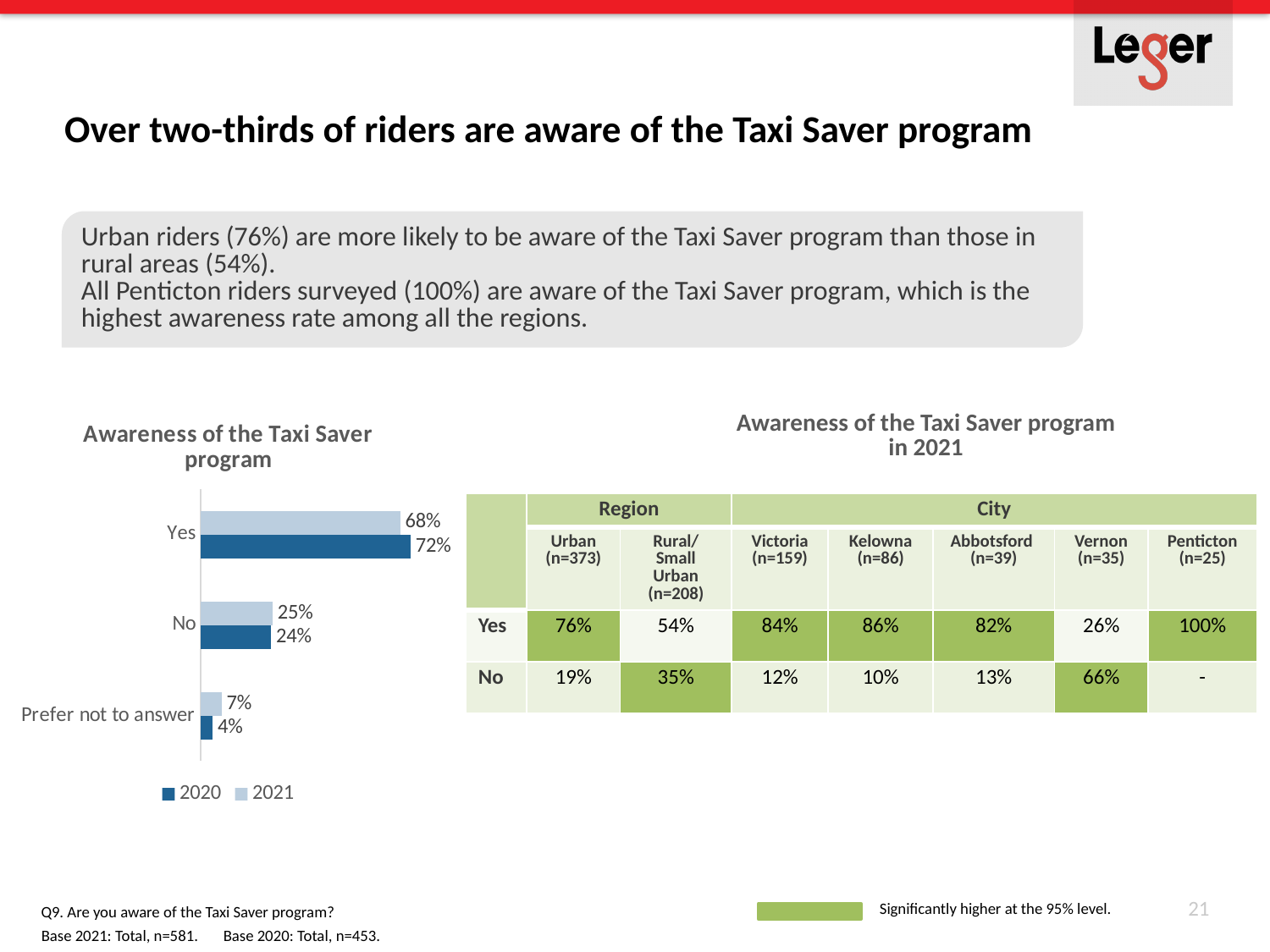
In the 'Awareness of the Taxi Saver program' chart, which category has the highest 2021 value? Yes In the 'Awareness of the Taxi Saver program' chart, what is the 2020 value for Prefer not to answer? 4% In the 'Awareness of the Taxi Saver program' chart, what is the 2021 value for No? 25% In the 'Awareness of the Taxi Saver program' chart, what is the 2020 value for Yes? 72% In the 'Awareness of the Taxi Saver program' chart, which category has the lowest 2020 value? Prefer not to answer In the 'Awareness of the Taxi Saver program' chart, what is the 2021 value for Yes? 68% How many categories are shown in the 'Awareness of the Taxi Saver program' chart? 3 In the 'Awareness of the Taxi Saver program' chart, what is the difference between the 2021 and 2020 values for Prefer not to answer? 3% What type of chart is the 'Awareness of the Taxi Saver program' chart? Bar chart In the 'Awareness of the Taxi Saver program' chart, which is larger for Yes: the 2020 value or the 2021 value? 2020 In the 'Awareness of the Taxi Saver program' chart, what is the difference between the 2020 and 2021 values for Yes? 4% How many series does the legend of the 'Awareness of the Taxi Saver program' chart list? 2